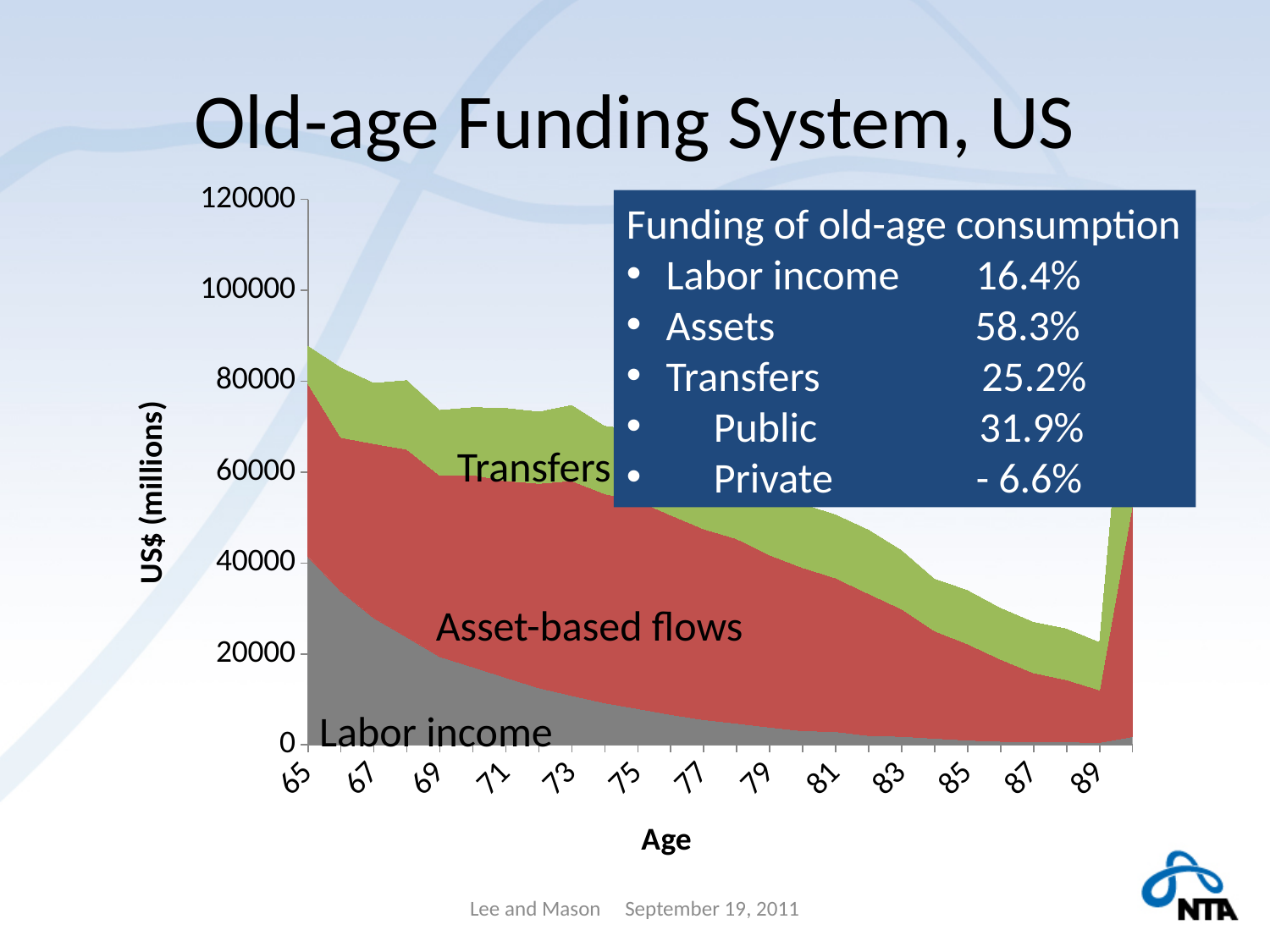
Is the value for Labor income at age 65 greater or less than 20000? greater Is the total stacked value at age 65 greater or less than 80000? greater Does Labor income rise or fall as age increases from 65 to 89? Fall How many age labels are shown along the x axis of the chart? 13 Does the total of all three areas rise or fall as age increases from 65 to 89? Fall What is the title of the slide containing the chart? Old-age Funding System, US Is the value for Labor income at age 85 greater or less than 20000? less How many series (labelled areas) are plotted in the chart? 3 At age 65, which is larger: Labor income or Transfers? Labor income What is the label on the vertical axis of the chart? US$ (millions) What kind of chart is shown on the slide? Stacked area chart